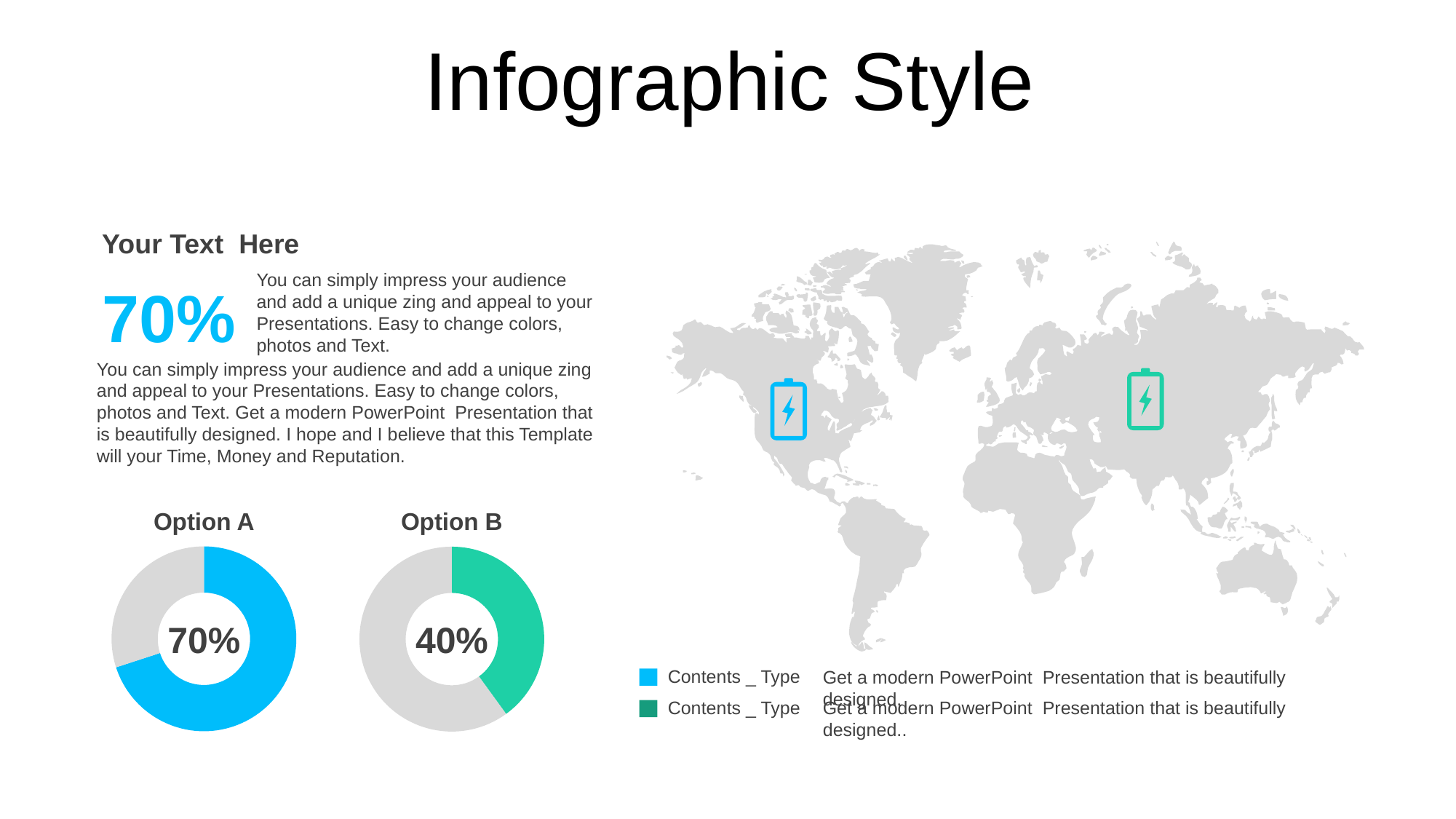
Is the value for Option B greater or less than 50%? less Which option has the higher percentage, Option A or Option B? Option A What is the difference between the Option A and Option B percentages? 30% What colour is the filled segment of the Option B donut chart? Green In the Option B donut chart, what share of the ring is grey? 60% Which of the two donut charts shows the lowest percentage? Option B What percentage is shown in the centre of the Option A donut chart? 70% What percentage is shown in the centre of the Option B donut chart? 40% How many donut charts are shown on the slide? 2 What kind of chart is used for Option A and Option B? Donut (pie) chart In the Option A donut chart, what share of the ring is not filled with the coloured segment? 30% What colour is the filled segment of the Option A donut chart? Blue